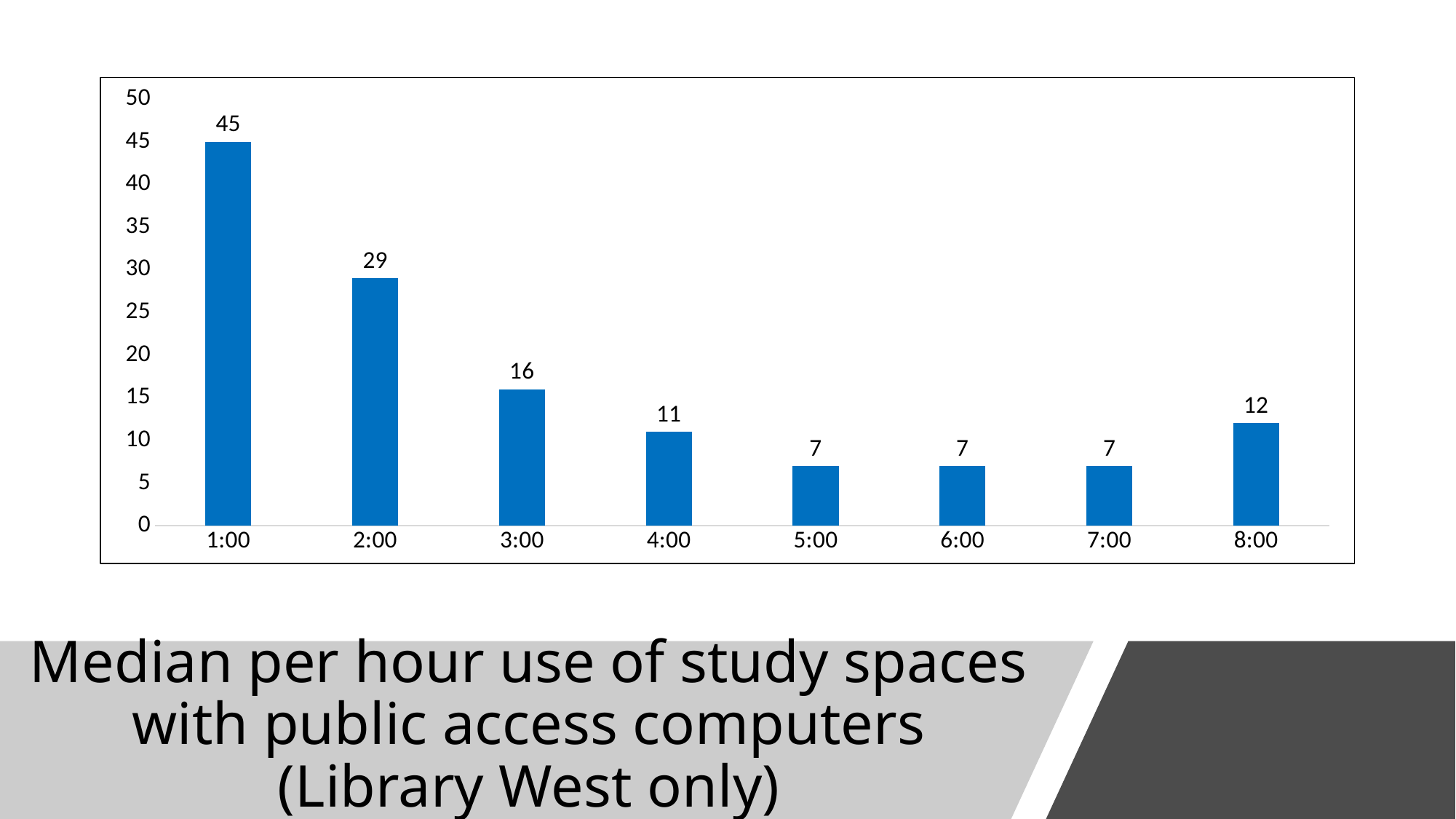
How many hours are shown on the x axis? 8 What is the difference between the values for 1:00 and 2:00? 16 Which is larger, the value for 3:00 or the value for 8:00? 3:00 Do the values rise or fall from 1:00 to 5:00? fall Which hour has the highest value? 1:00 How many hours have a value of 7? 3 What is the value for 3:00? 16 What is the value for 8:00? 12 What kind of chart is shown on the slide? bar chart What is the difference between the values for 4:00 and 8:00? 1 Is the value for 2:00 greater or less than 25? greater What is the value for 1:00? 45